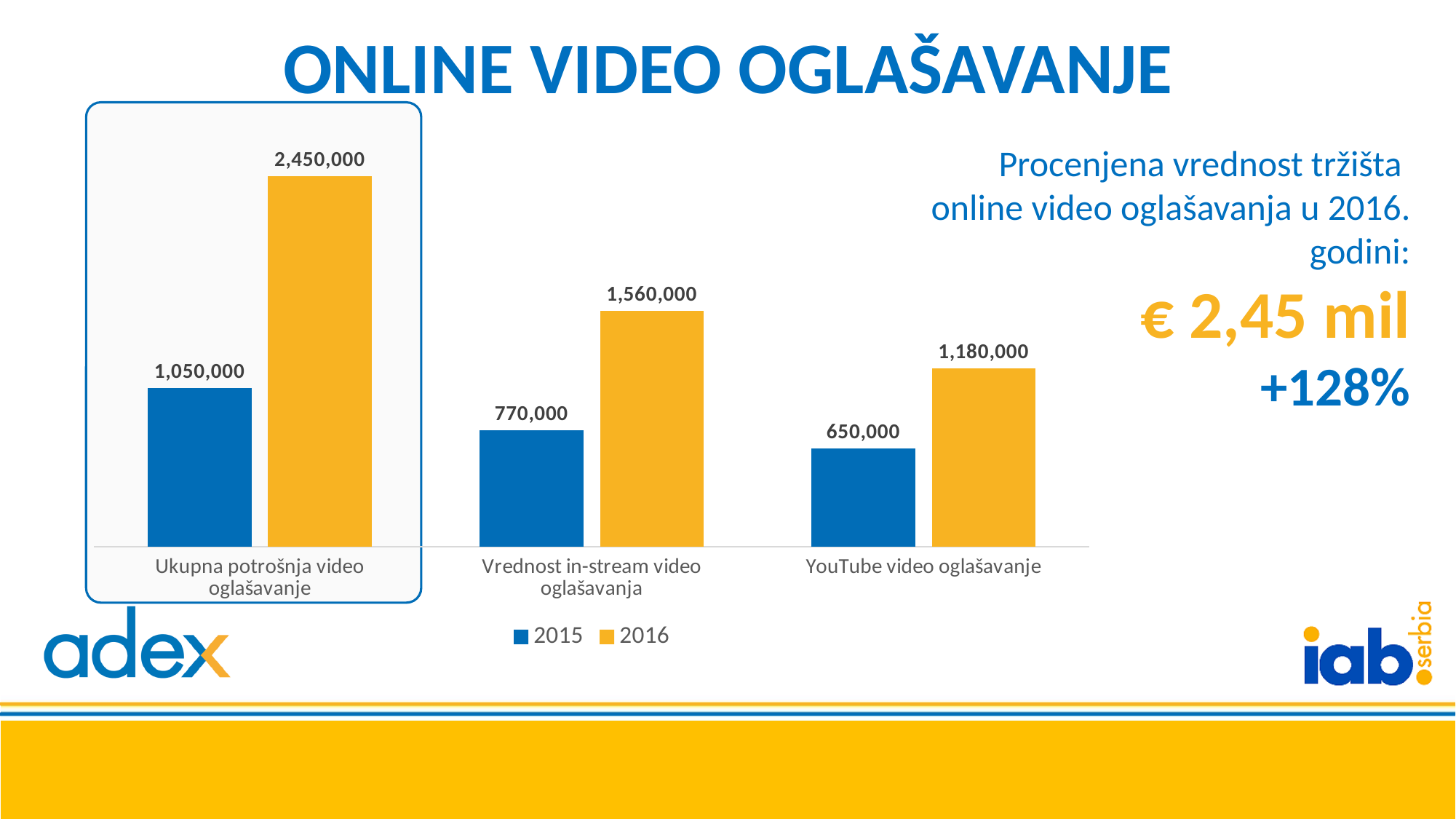
How many series does the legend list? 2 What is the 2016 value for Ukupna potrošnja video oglašavanje? 2,450,000 What is the difference between the 2016 values for Vrednost in-stream video oglašavanja and YouTube video oglašavanje? 380,000 Which is larger: the 2015 value for Vrednost in-stream video oglašavanja or the 2015 value for YouTube video oglašavanje? Vrednost in-stream video oglašavanja What is the 2015 value for YouTube video oglašavanje? 650,000 Which category has the highest 2016 value? Ukupna potrošnja video oglašavanje What is the 2016 value for YouTube video oglašavanje? 1,180,000 Which category has the lowest 2015 value? YouTube video oglašavanje What kind of chart is shown on the slide? Bar chart What is the difference between the 2016 and 2015 values for Ukupna potrošnja video oglašavanje? 1,400,000 How many categories are shown on the x axis? 3 What is the 2015 value for Vrednost in-stream video oglašavanja? 770,000